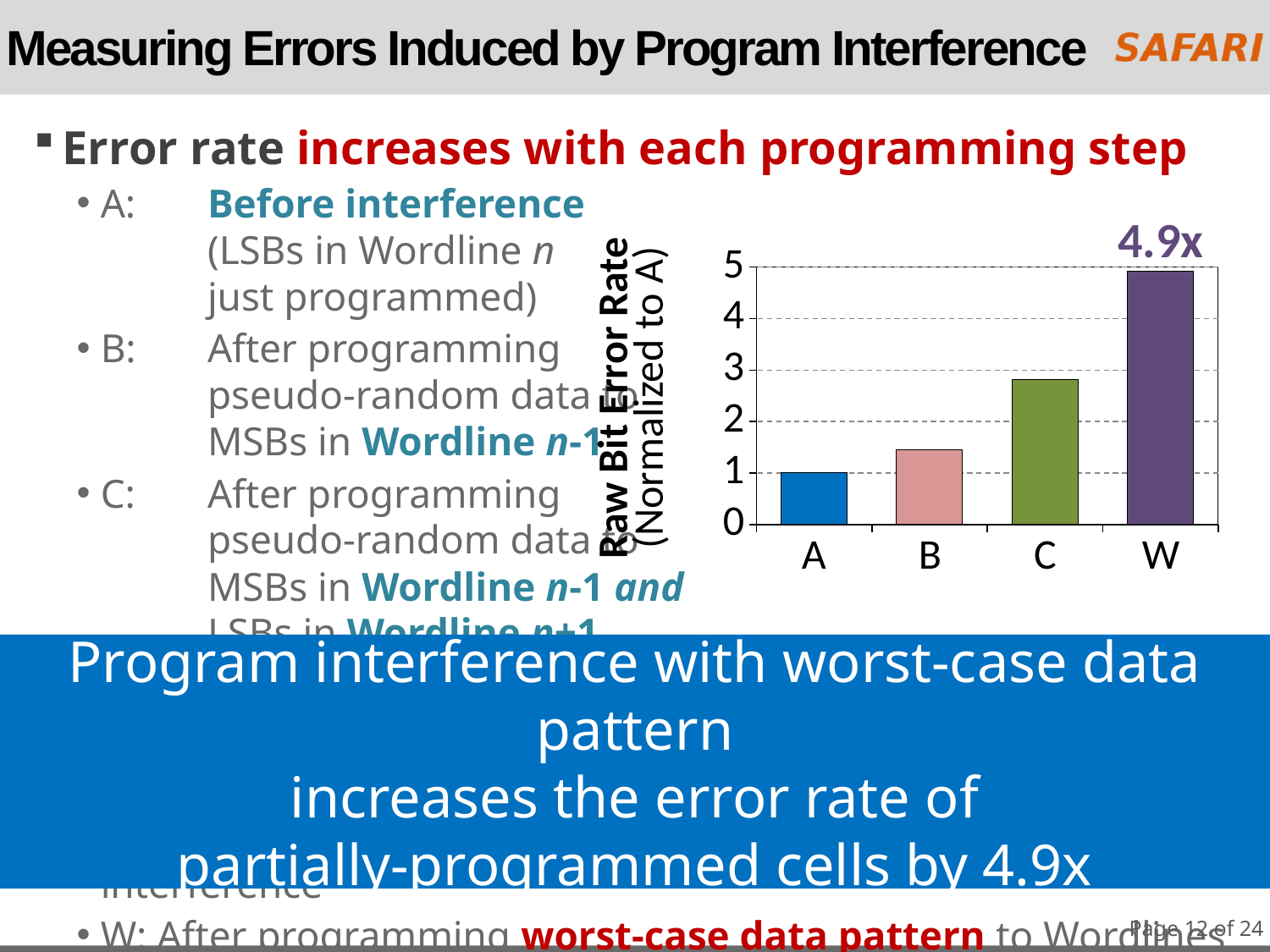
Which category has the highest raw bit error rate in the chart? W Do the bar values rise or fall from A to W along the x axis? rise Is the value for C greater or less than 3? less What kind of chart is shown on the slide? bar chart Which category has the lowest raw bit error rate in the chart? A Is the value for B greater or less than 2? less What is the normalized raw bit error rate for category A? 1 What is the label on the vertical axis of the chart? Raw Bit Error Rate (Normalized to A) Is the value for C greater or less than 2? greater How many bars (categories) are plotted in the chart? 4 What value is labeled above the bar for W? 4.9x Which has a larger raw bit error rate, B or C? C